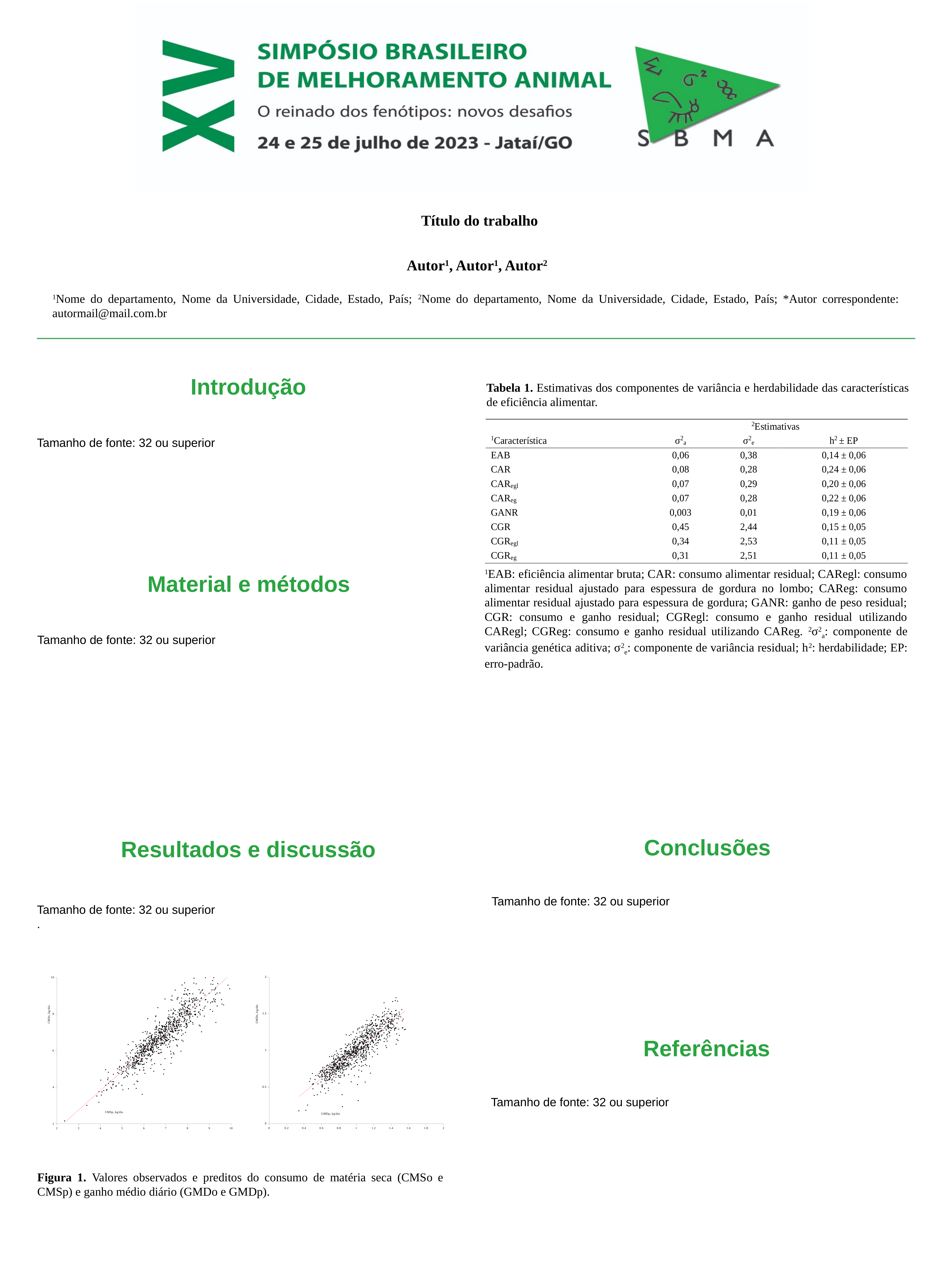
How many charts are shown in Figura 1? 2 In the left chart of Figura 1, do the points rise or fall as the x-axis value increases? rise What kind of chart is the left chart in Figura 1? scatter plot What is the x-axis label of the right chart in Figura 1? GMDp, kg/dia In the right chart of Figura 1, do the points rise or fall as the x-axis value increases? rise What is the highest tick value shown on the x-axis of the left chart in Figura 1? 10 What is the x-axis label of the left chart in Figura 1? CMSp, kg/dia What kind of chart is the right chart in Figura 1? scatter plot